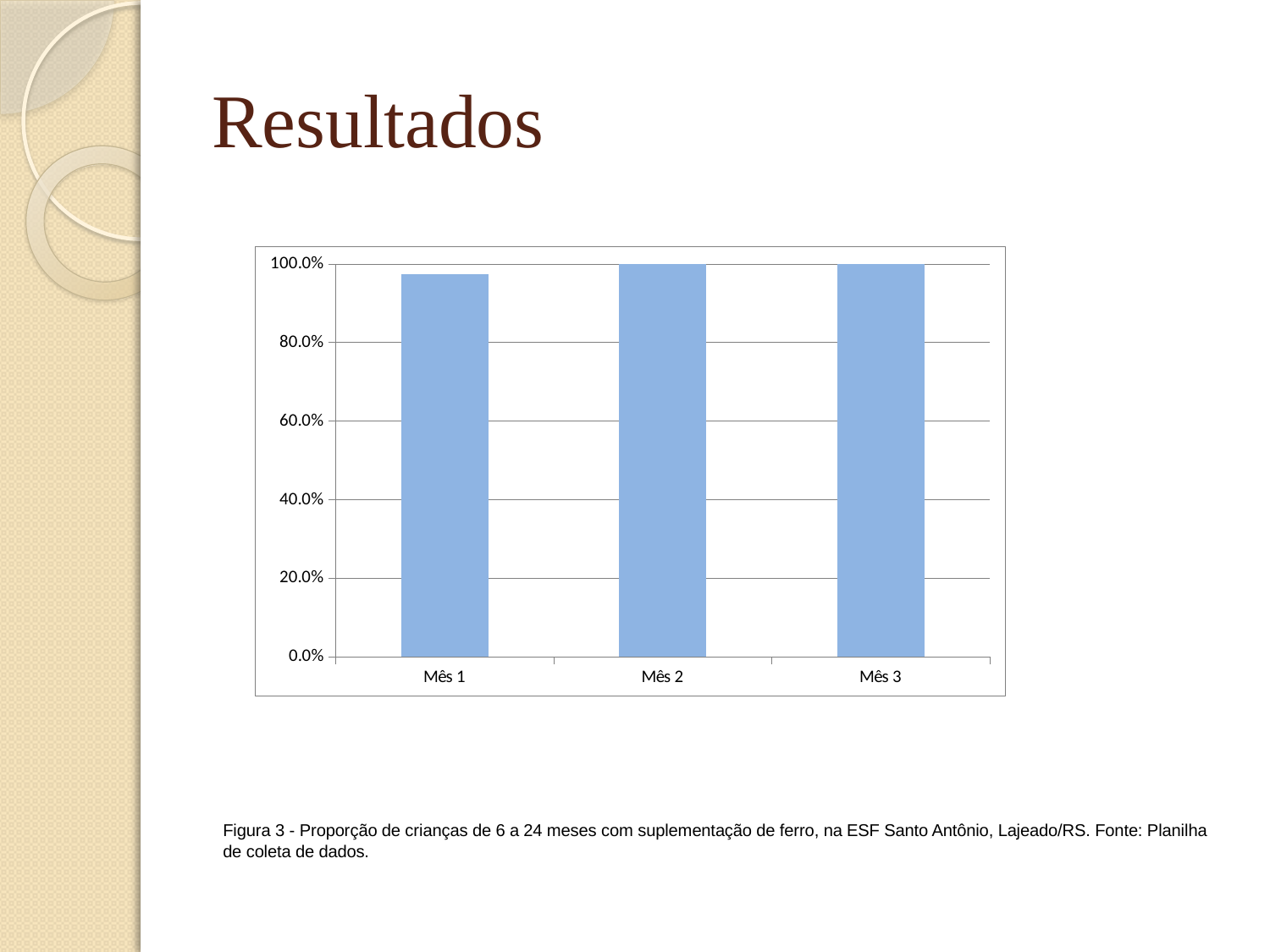
What is the value for Mês 2? 100.0% Is the value for Mês 1 greater or less than 100.0%? less Is the value for Mês 1 greater or less than 80.0%? greater What kind of chart is shown on the slide? bar chart Do the values rise or fall from Mês 1 to Mês 2? rise Which category has the lowest value? Mês 1 What is the value for Mês 3? 100.0% Which is larger, the value for Mês 1 or the value for Mês 2? Mês 2 What is the highest value shown on the y axis of the chart? 100.0% Which is larger, the value for Mês 3 or the value for Mês 1? Mês 3 What colour are the bars in the chart? blue How many categories are shown on the x axis of the chart? 3